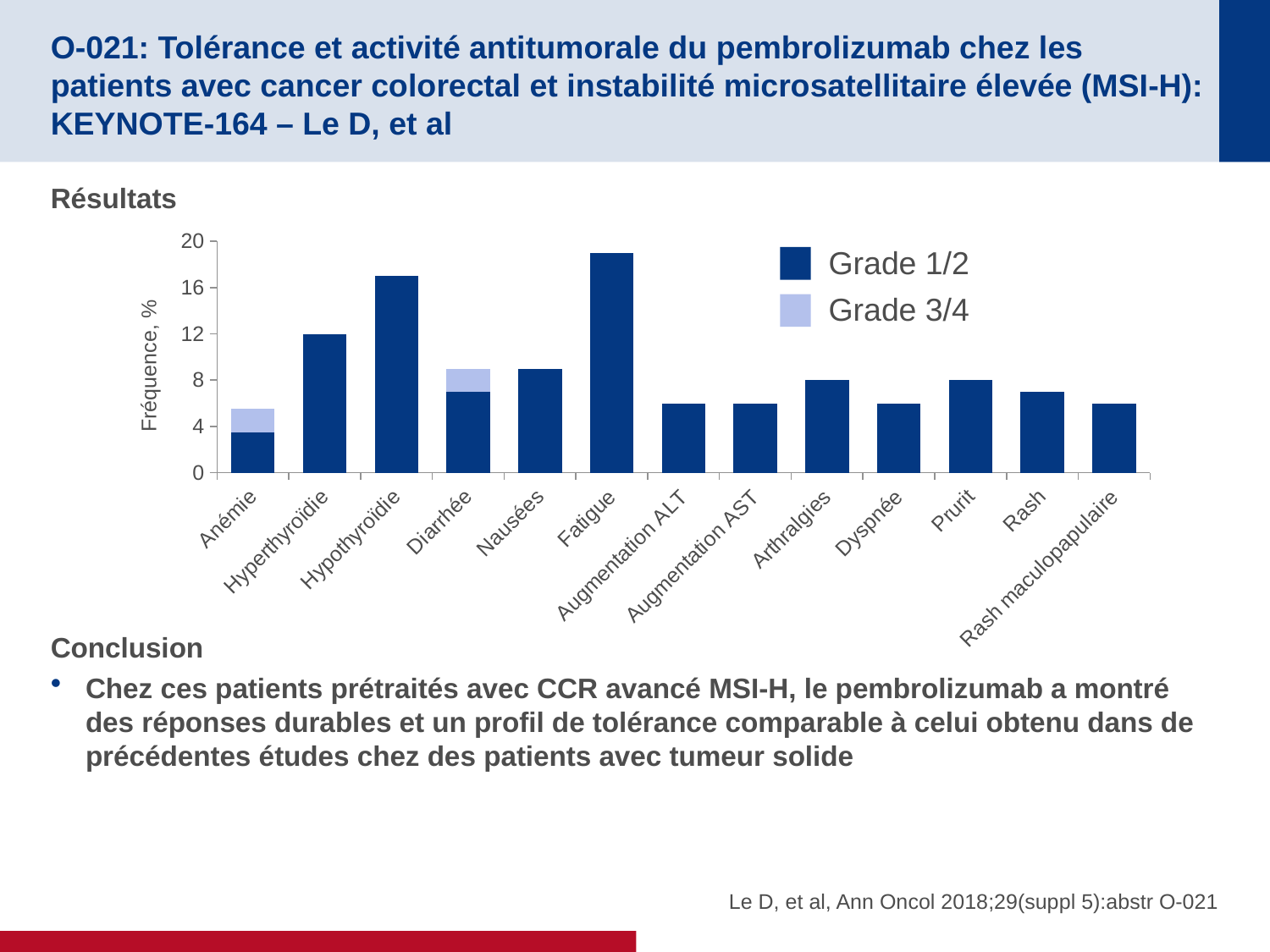
What is the frequency (%) for Hyperthyroïdie? 12 Which has a higher frequency, Hyperthyroïdie or Nausées? Hyperthyroïdie What is the frequency (%) for Arthralgies? 8 Is the frequency for Fatigue greater or less than 16? greater Which has a higher frequency, Fatigue or Hypothyroïdie? Fatigue What is the label of the y axis? Fréquence, % What kind of chart is shown on the slide? bar chart How many adverse event categories are shown on the x axis? 13 Is the frequency for Hypothyroïdie greater or less than 16? greater Is the frequency for Dyspnée greater or less than 8? less How many series does the legend list? 2 Which adverse event has the highest frequency? Fatigue